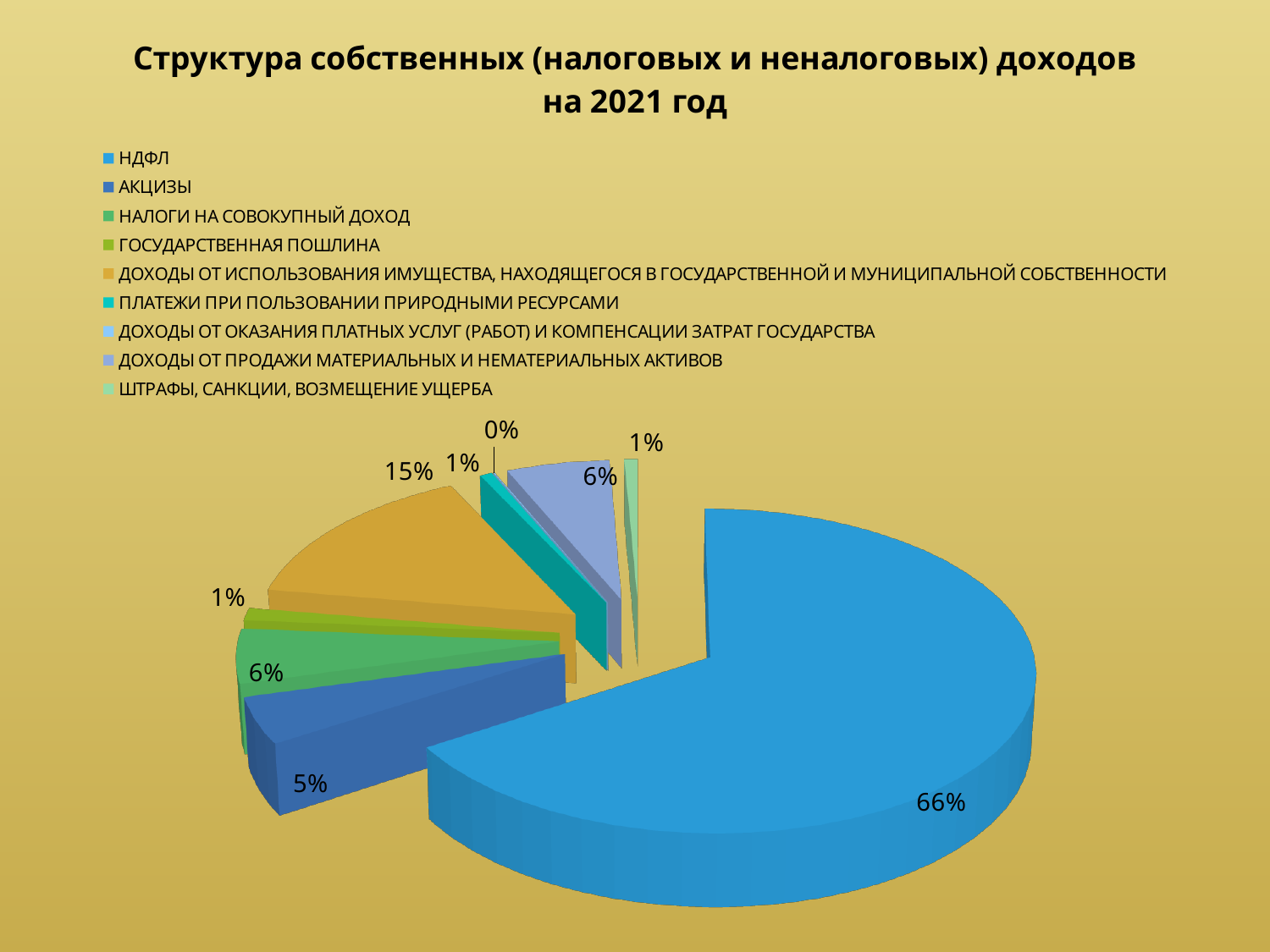
What is the title of the chart? Структура собственных (налоговых и неналоговых) доходов на 2021 год What percentage is shown for ДОХОДЫ ОТ ОКАЗАНИЯ ПЛАТНЫХ УСЛУГ (РАБОТ) И КОМПЕНСАЦИИ ЗАТРАТ ГОСУДАРСТВА? 0% What is the difference in percentage points between НДФЛ and ДОХОДЫ ОТ ИСПОЛЬЗОВАНИЯ ИМУЩЕСТВА, НАХОДЯЩЕГОСЯ В ГОСУДАРСТВЕННОЙ И МУНИЦИПАЛЬНОЙ СОБСТВЕННОСТИ? 51% How many categories does the legend list? 9 Which category has the smallest share of the pie? ДОХОДЫ ОТ ОКАЗАНИЯ ПЛАТНЫХ УСЛУГ (РАБОТ) И КОМПЕНСАЦИИ ЗАТРАТ ГОСУДАРСТВА What percentage is shown for АКЦИЗЫ? 5% What share of the pie does НДФЛ have? 66% What percentage is shown for ДОХОДЫ ОТ ИСПОЛЬЗОВАНИЯ ИМУЩЕСТВА, НАХОДЯЩЕГОСЯ В ГОСУДАРСТВЕННОЙ И МУНИЦИПАЛЬНОЙ СОБСТВЕННОСТИ? 15% What type of chart is shown on the slide? pie chart What percentage is shown for НАЛОГИ НА СОВОКУПНЫЙ ДОХОД? 6% Which is larger, the share for АКЦИЗЫ or the share for НАЛОГИ НА СОВОКУПНЫЙ ДОХОД? НАЛОГИ НА СОВОКУПНЫЙ ДОХОД Which category has the largest share of the pie? НДФЛ